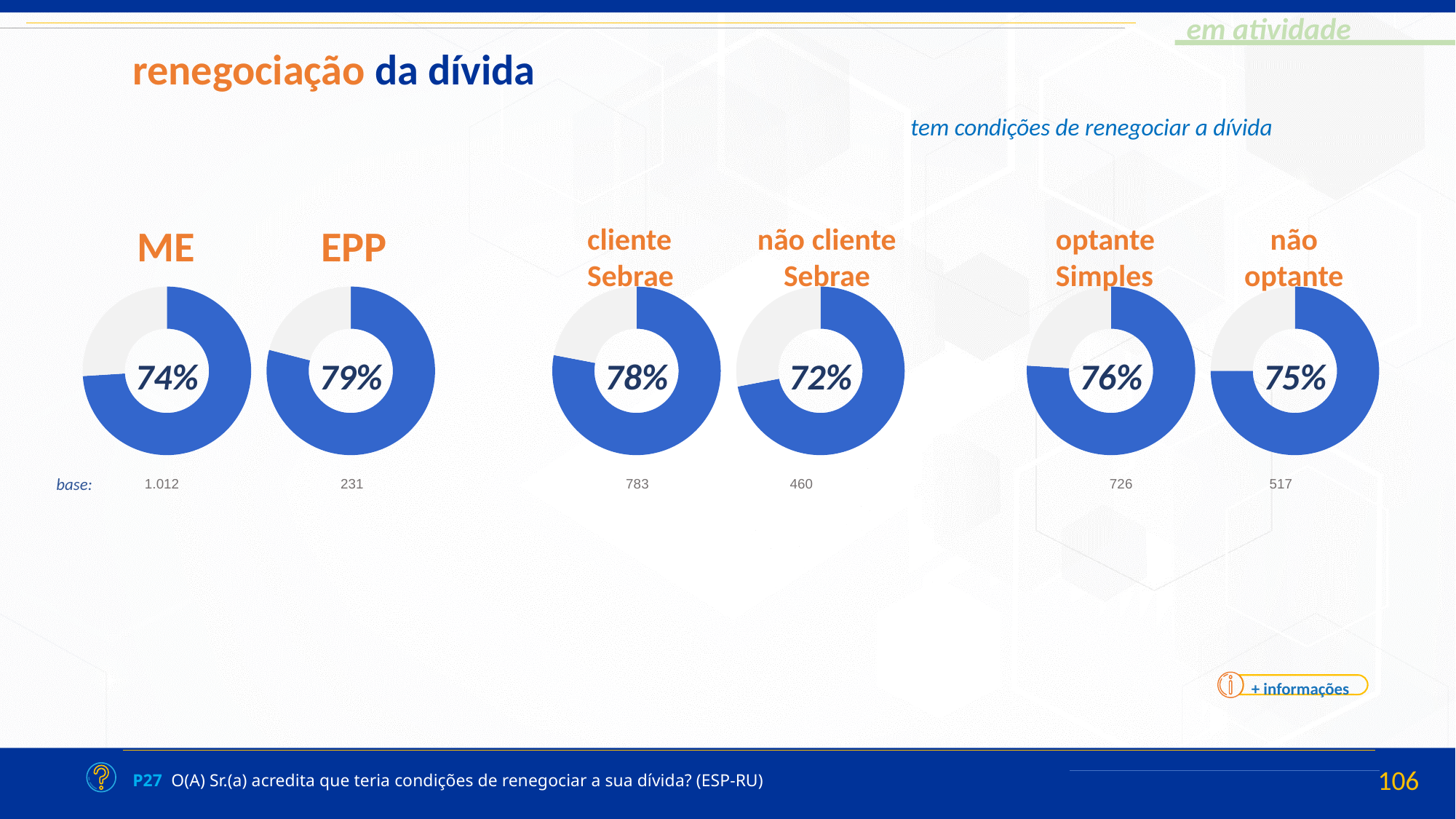
How many donut charts are shown on the slide? 6 In the EPP donut chart, what percentage is shown? 79% What is the difference in percentage points between the 'cliente Sebrae' chart and the 'não cliente Sebrae' chart? 6 In the 'não optante' donut chart, what percentage is shown? 75% In the ME donut chart, what percentage is shown for those who have conditions to renegotiate the debt? 74% In the 'cliente Sebrae' donut chart, what percentage is shown? 78% Across the six donut charts on the slide, which group has the highest percentage? EPP Across the six donut charts on the slide, which group has the lowest percentage? não cliente Sebrae In the 'optante Simples' donut chart, what percentage is shown? 76% What kind of chart is used to show the percentages on this slide? Donut (pie) chart Which is larger, the percentage in the ME chart or the percentage in the EPP chart? EPP In the 'não cliente Sebrae' donut chart, what percentage is shown? 72%